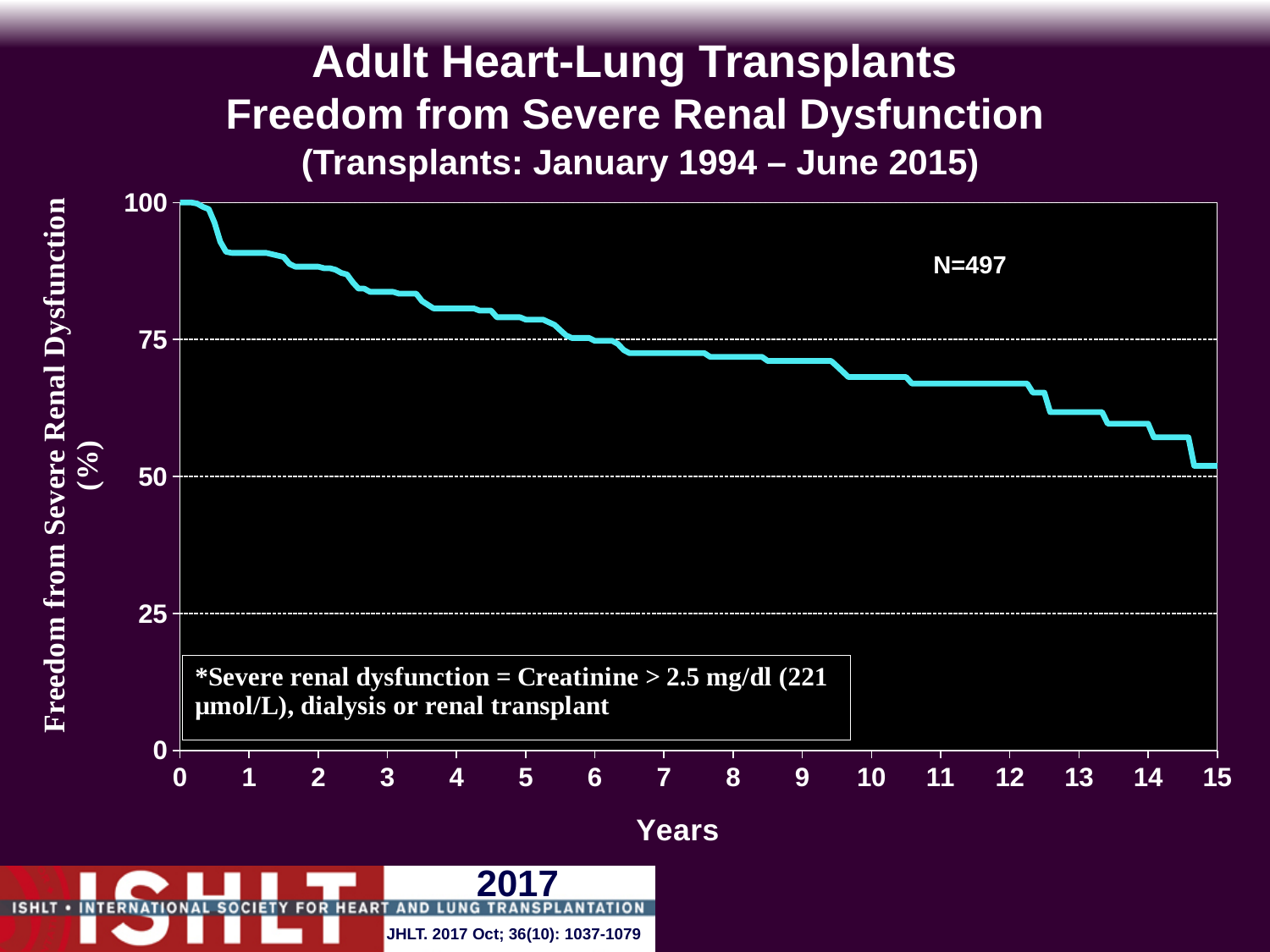
What is the value of freedom from severe renal dysfunction at year 0? 100 What kind of chart is shown on the slide? line chart Is the value for freedom from severe renal dysfunction at year 5 greater or less than 75? greater Which is larger, the freedom from severe renal dysfunction at year 2 or at year 13? year 2 Does the freedom from severe renal dysfunction rise or fall as years increase? fall Is the value for freedom from severe renal dysfunction at year 10 greater or less than 75? less Is the value for freedom from severe renal dysfunction at year 1 greater or less than 75? greater What is the sample size (N) shown on the chart? N=497 What is the label of the x axis? Years